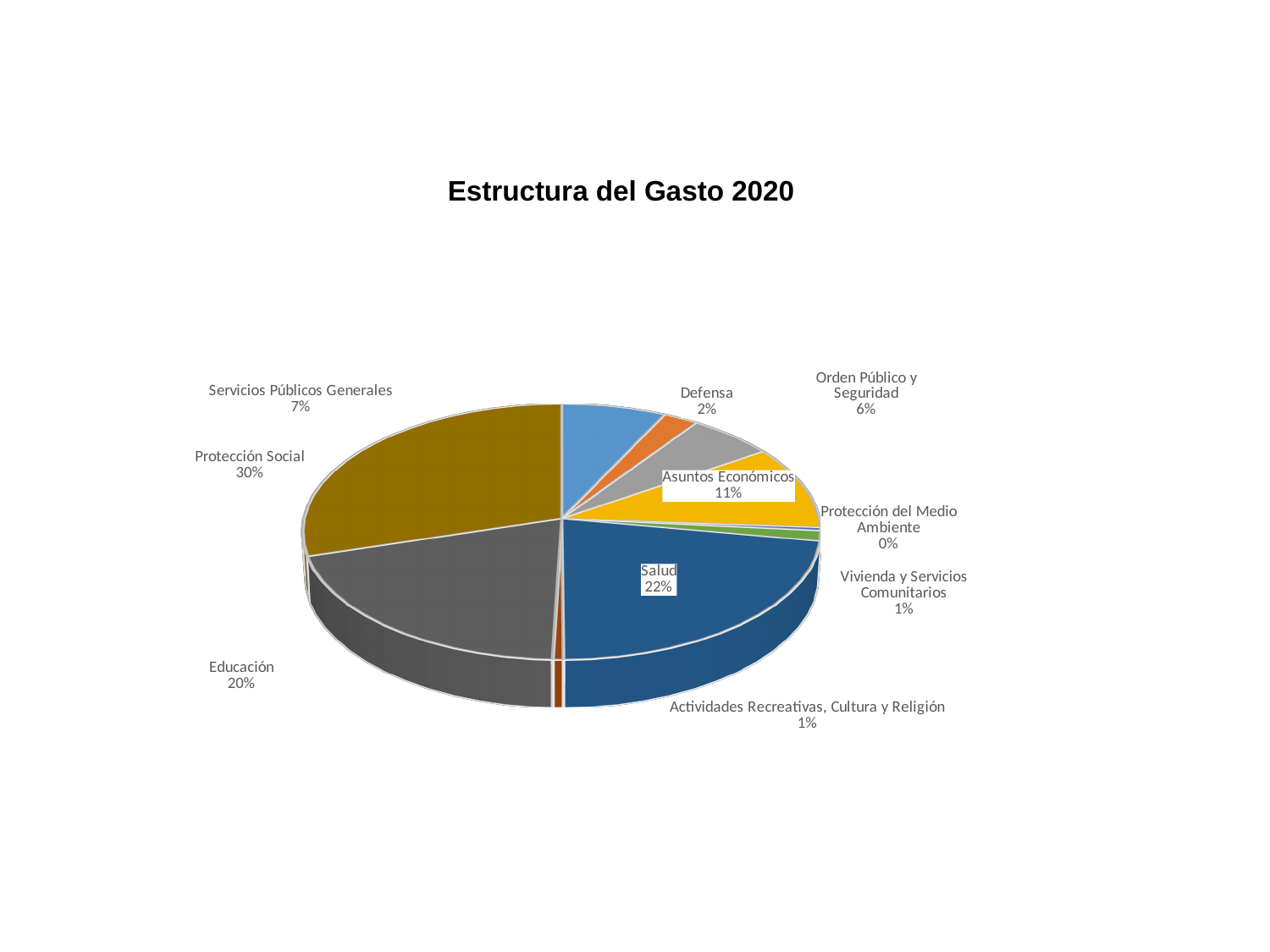
What share of the pie does Asuntos Económicos represent? 11% What is the difference in percentage points between Protección Social and Educación? 10 Which category has the largest share of the pie? Protección Social What is the title of the chart? Estructura del Gasto 2020 How many categories are shown in the pie chart? 10 Which category has the smallest share of the pie? Protección del Medio Ambiente What share of the pie does Salud represent? 22% What share of the pie does Defensa represent? 2% Which is larger, the share for Salud or the share for Asuntos Económicos? Salud What kind of chart is shown on the slide? Pie chart